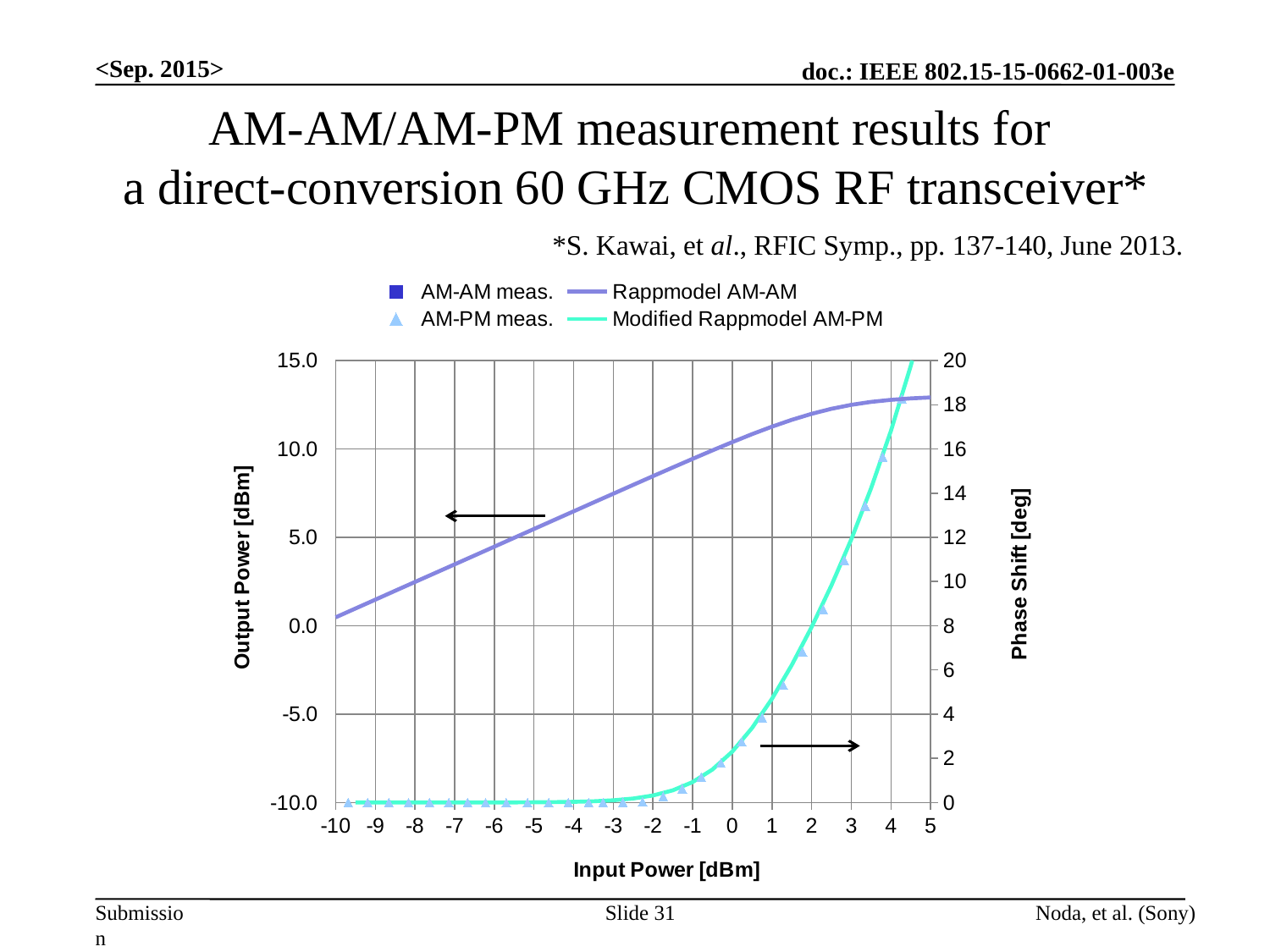
Does the Rappmodel AM-AM curve rise or fall as input power increases from -10 to 5 dBm? rise What is the title of the x axis? Input Power [dBm] Is the Modified Rappmodel AM-PM phase shift at an input power of 3 dBm greater or less than 8 deg? greater Is the Modified Rappmodel AM-PM phase shift at an input power of 0 dBm greater or less than 4 deg? less How many series does the legend list? 4 What kind of chart is shown on the slide? line chart For the Rappmodel AM-AM curve, is the output power higher at an input power of 5 dBm or at -10 dBm? 5 dBm Is the Modified Rappmodel AM-PM phase shift at an input power of -5 dBm greater or less than 2 deg? less What is the title of the right-hand y axis? Phase Shift [deg] What is the maximum value shown on the left-hand Output Power axis? 15.0